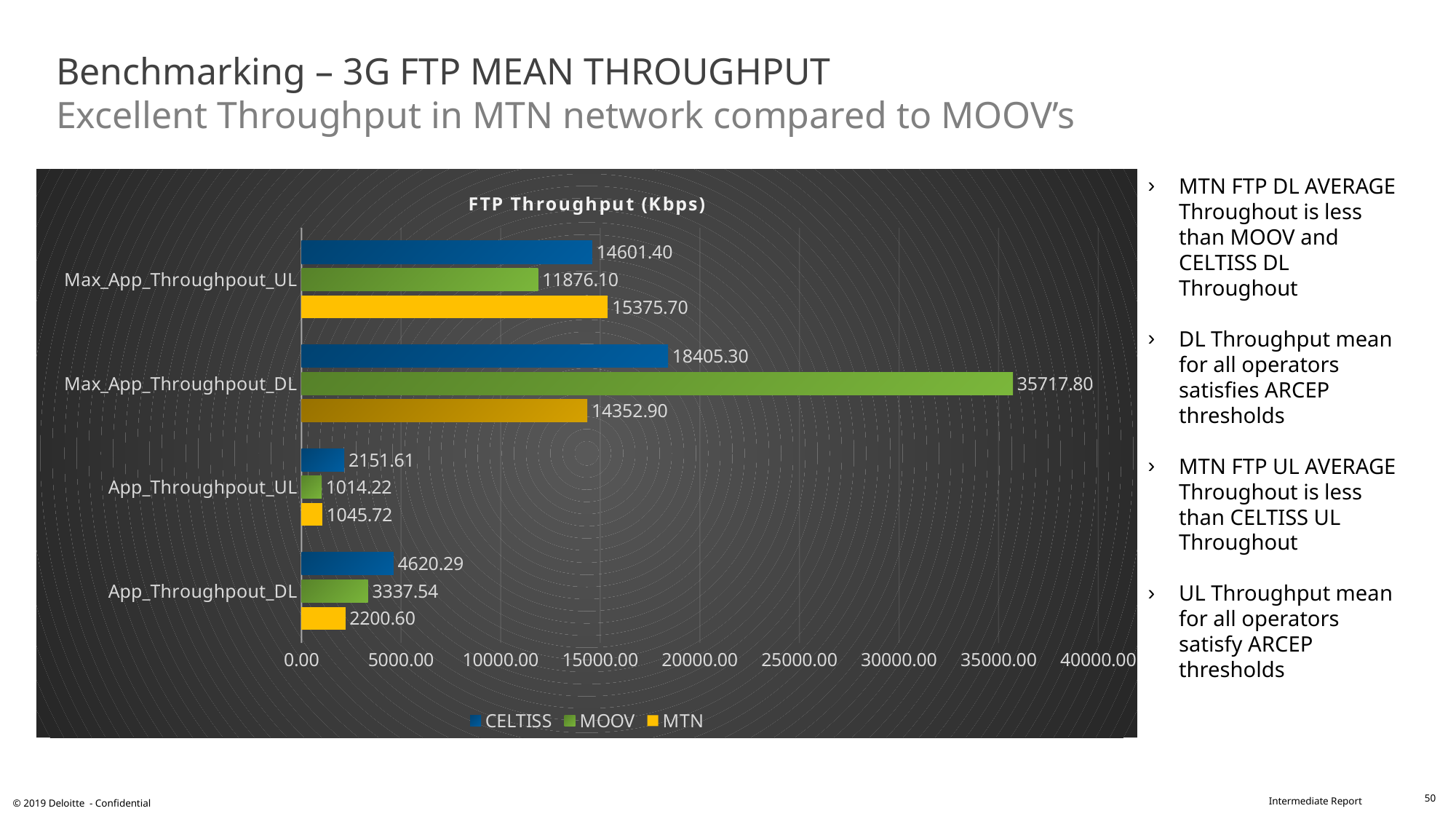
What is the MOOV value for Max_App_Throughpout_DL? 35717.80 For Max_App_Throughpout_UL, which is larger: the CELTISS value or the MOOV value? CELTISS What is the difference between the CELTISS and MTN values for App_Throughpout_DL? 2419.69 What is the CELTISS value for App_Throughpout_UL? 2151.61 What is the difference between the MOOV and CELTISS values for Max_App_Throughpout_DL? 17312.50 How many categories are shown on the chart? 4 Which operator has the lowest value for App_Throughpout_DL? MTN What is the MTN value for App_Throughpout_DL? 2200.60 What is the MTN value for Max_App_Throughpout_UL? 15375.70 How many series does the legend list? 3 What type of chart is shown on the slide? Bar chart Which operator has the highest value for Max_App_Throughpout_DL? MOOV